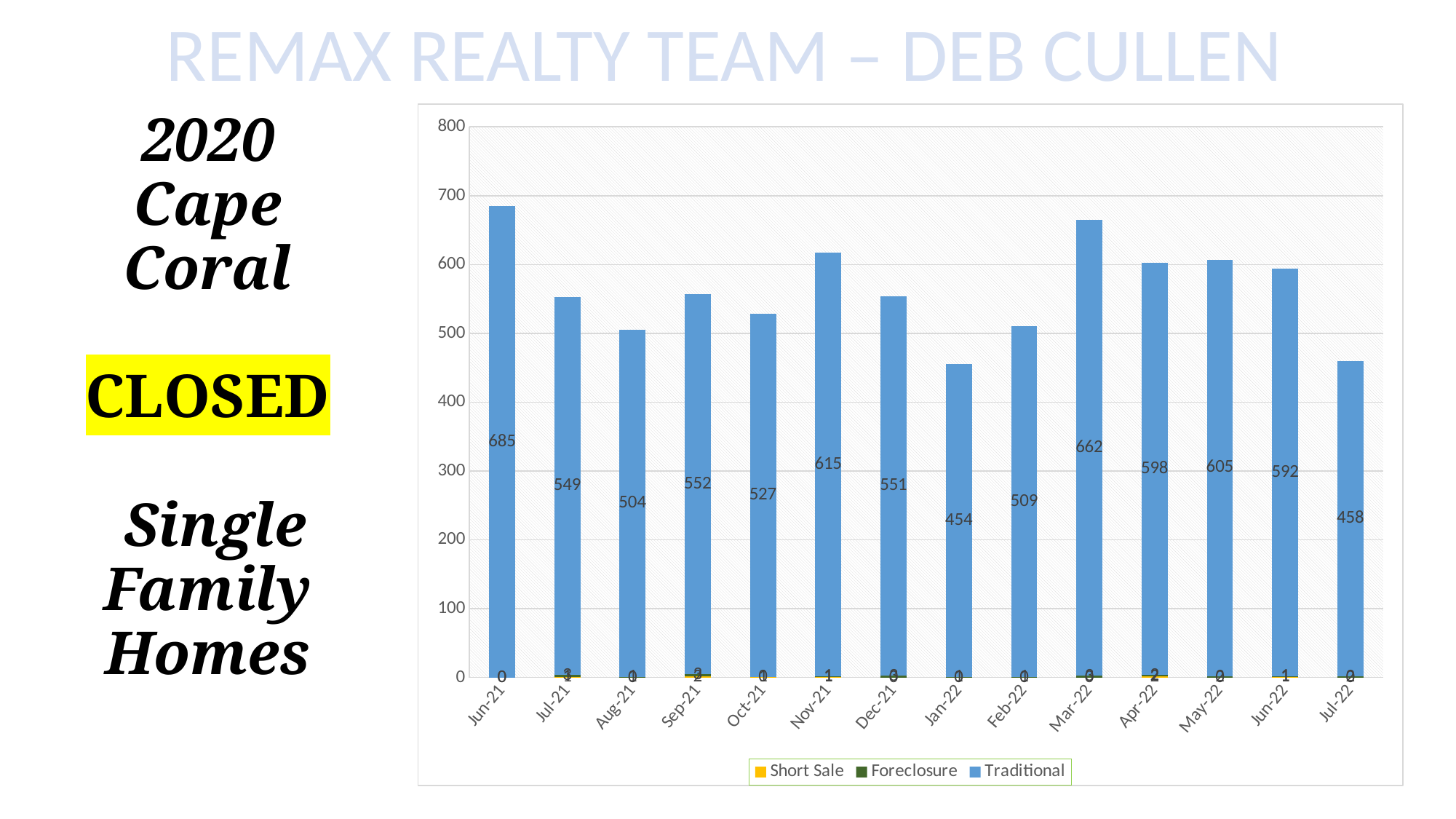
What kind of chart is shown on the slide? bar chart What is the Traditional value for Jun-21? 685 What is the Traditional value for Jan-22? 454 What is the difference between the Traditional values for Jun-21 and Jul-21? 136 Is the Traditional value for Jul-22 greater or less than 500? less Which month has the lowest Traditional value? Jan-22 Do the Traditional values rise or fall from Jan-22 to Mar-22? rise What is the Traditional value for Mar-22? 662 Which month has the highest Traditional value? Jun-21 How many series does the legend list? 3 How many months are shown on the x axis? 14 Which has a larger Traditional value, Nov-21 or Mar-22? Mar-22